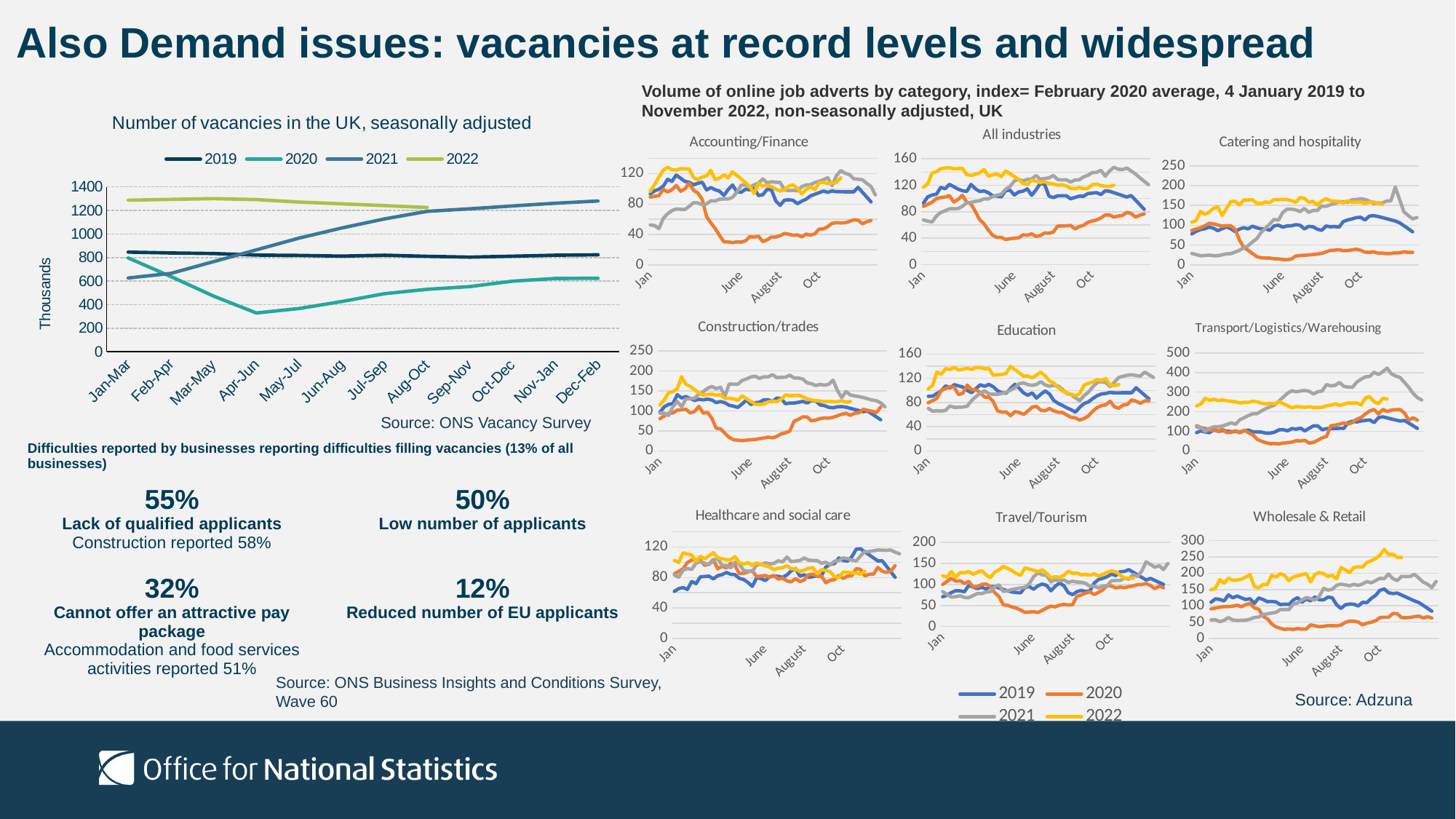
What is the source given for the 'Number of vacancies in the UK, seasonally adjusted' chart? ONS Vacancy Survey How many series does the legend of 'Number of vacancies in the UK, seasonally adjusted' list? 4 In 'Number of vacancies in the UK, seasonally adjusted', which series has the lowest value at Apr-Jun? 2020 In 'Number of vacancies in the UK, seasonally adjusted', is the 2021 value for Jan-Mar greater or less than 800? less In 'Number of vacancies in the UK, seasonally adjusted', is the 2020 value for Apr-Jun greater or less than 400? less In 'Number of vacancies in the UK, seasonally adjusted', does the 2021 series rise or fall from Jan-Mar to Dec-Feb? rise How many periods are shown on the x axis of 'Number of vacancies in the UK, seasonally adjusted'? 12 In 'Number of vacancies in the UK, seasonally adjusted', is the 2022 value for Jan-Mar greater or less than 1200? greater In 'Number of vacancies in the UK, seasonally adjusted', which series has the highest value at Jan-Mar? 2022 In 'Number of vacancies in the UK, seasonally adjusted', which is larger at Dec-Feb: the 2021 value or the 2019 value? 2021 How many small charts are shown under 'Volume of online job adverts by category'? 9 What kind of chart is 'Number of vacancies in the UK, seasonally adjusted'? line chart